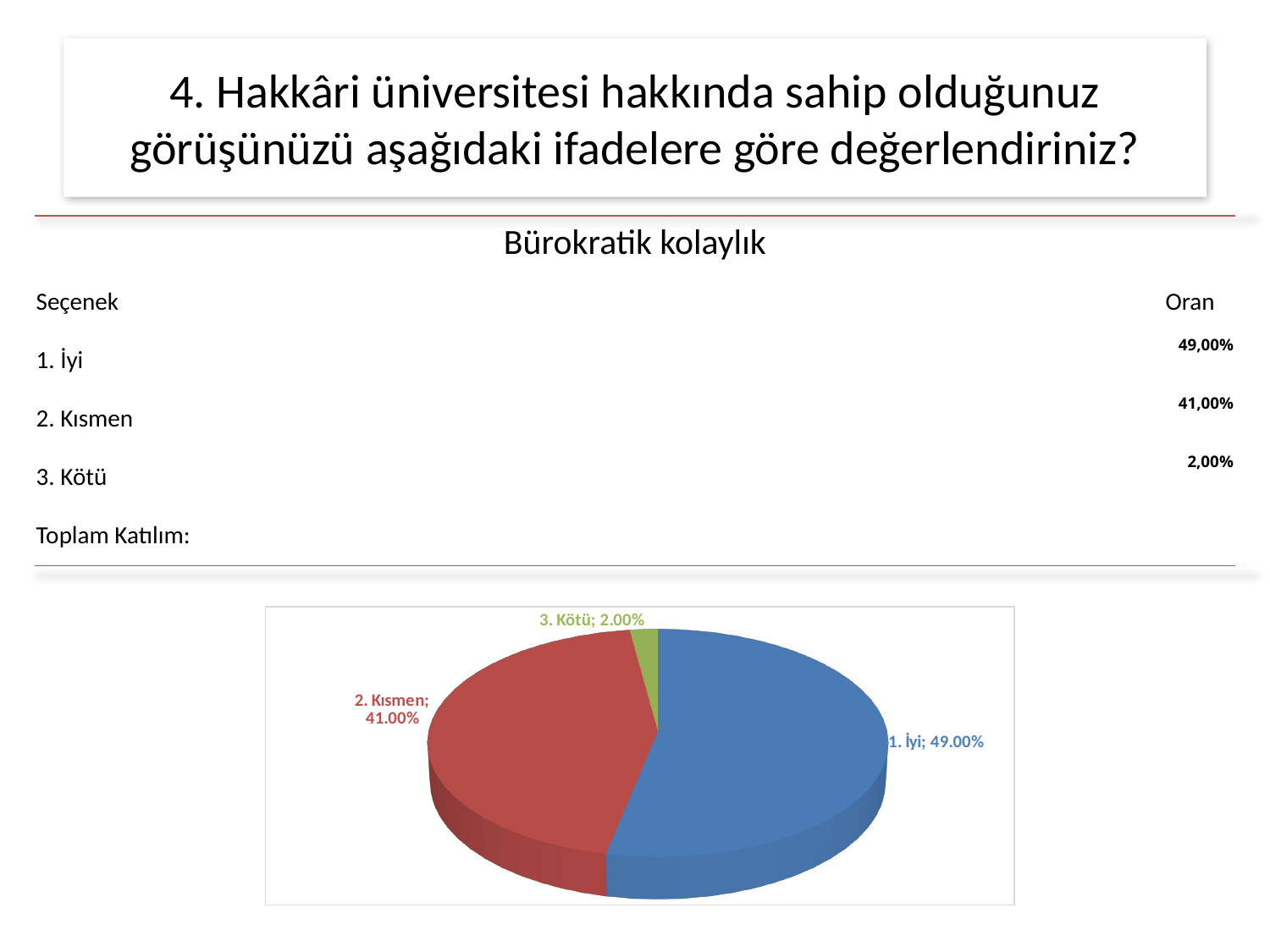
What kind of chart is shown on the slide? pie chart What is the value shown for the slice labelled 3. Kötü? 2.00% Which is larger, the slice for 2. Kısmen or the slice for 3. Kötü? 2. Kısmen What colour is the slice for 1. İyi? blue How many slices does the pie chart have? 3 Which slice of the pie chart is the smallest? 3. Kötü What is the value shown for the slice labelled 1. İyi? 49.00% What is the value shown for the slice labelled 2. Kısmen? 41.00% What colour is the slice for 2. Kısmen? red What is the difference between the values for 1. İyi and 2. Kısmen? 8.00% What is the difference between the values for 2. Kısmen and 3. Kötü? 39.00% Which slice of the pie chart is the largest? 1. İyi